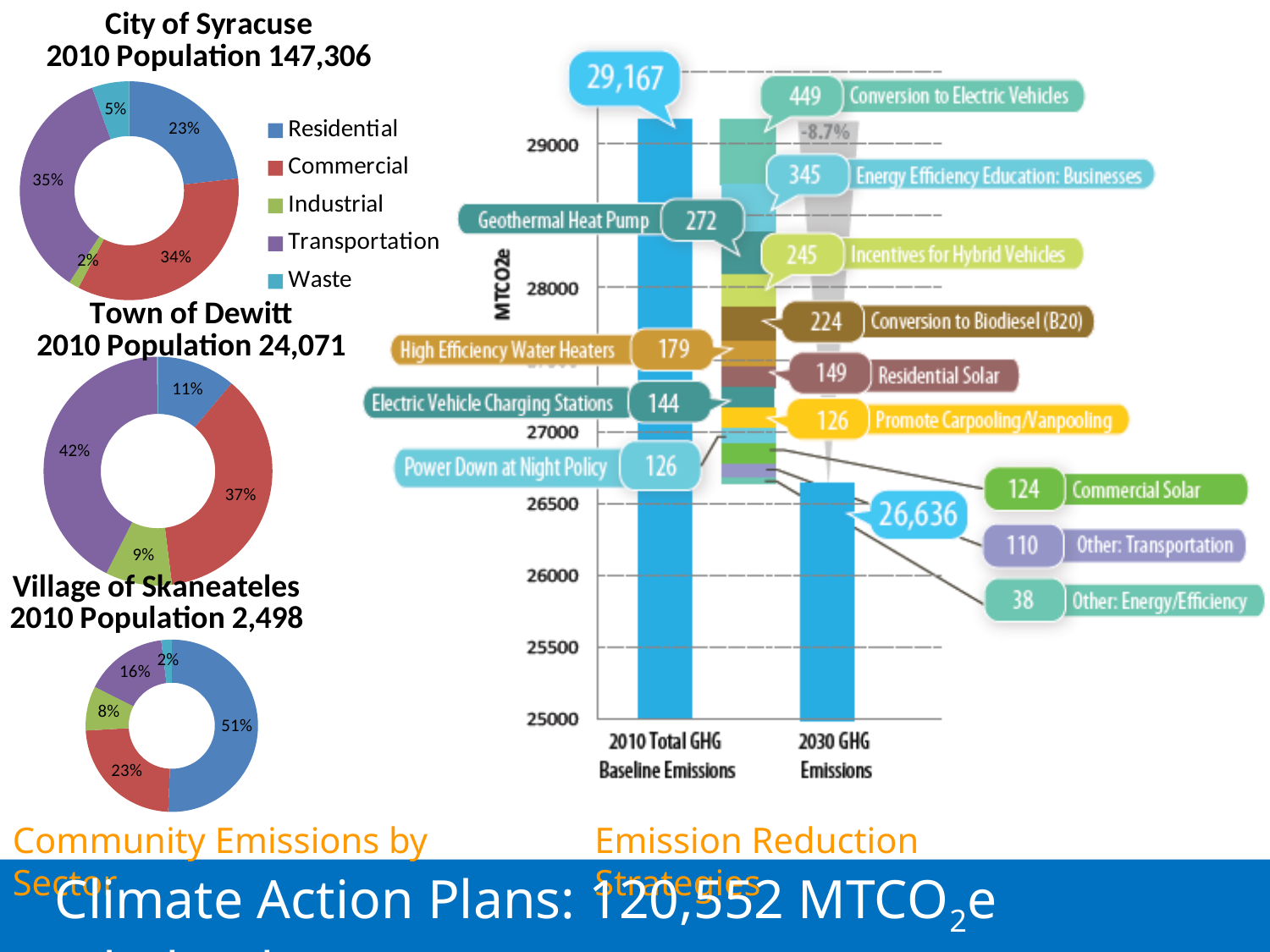
In the City of Syracuse donut chart, which sector has the smallest share? Industrial How many sectors does the legend next to the City of Syracuse donut chart list? 5 In the Village of Skaneateles donut chart, what is the difference between the Commercial and Industrial shares? 15% In the City of Syracuse donut chart, what share of emissions comes from Transportation? 35% In the Town of Dewitt donut chart, what share of emissions comes from Commercial? 37% In the Emission Reduction Strategies chart, what is the value of the 2010 Total GHG Baseline Emissions bar? 29,167 In the Emission Reduction Strategies chart, what is the value of the 2030 GHG Emissions bar? 26,636 In the Emission Reduction Strategies chart, which is larger: the reduction for Residential Solar or for Commercial Solar? Residential Solar In the Town of Dewitt donut chart, which sector has the largest share? Transportation In the Emission Reduction Strategies chart, which strategy has the largest reduction value? Conversion to Electric Vehicles In the Emission Reduction Strategies chart, what is the reduction value for Geothermal Heat Pump? 272 In the Village of Skaneateles donut chart, what share of emissions comes from Residential? 51%